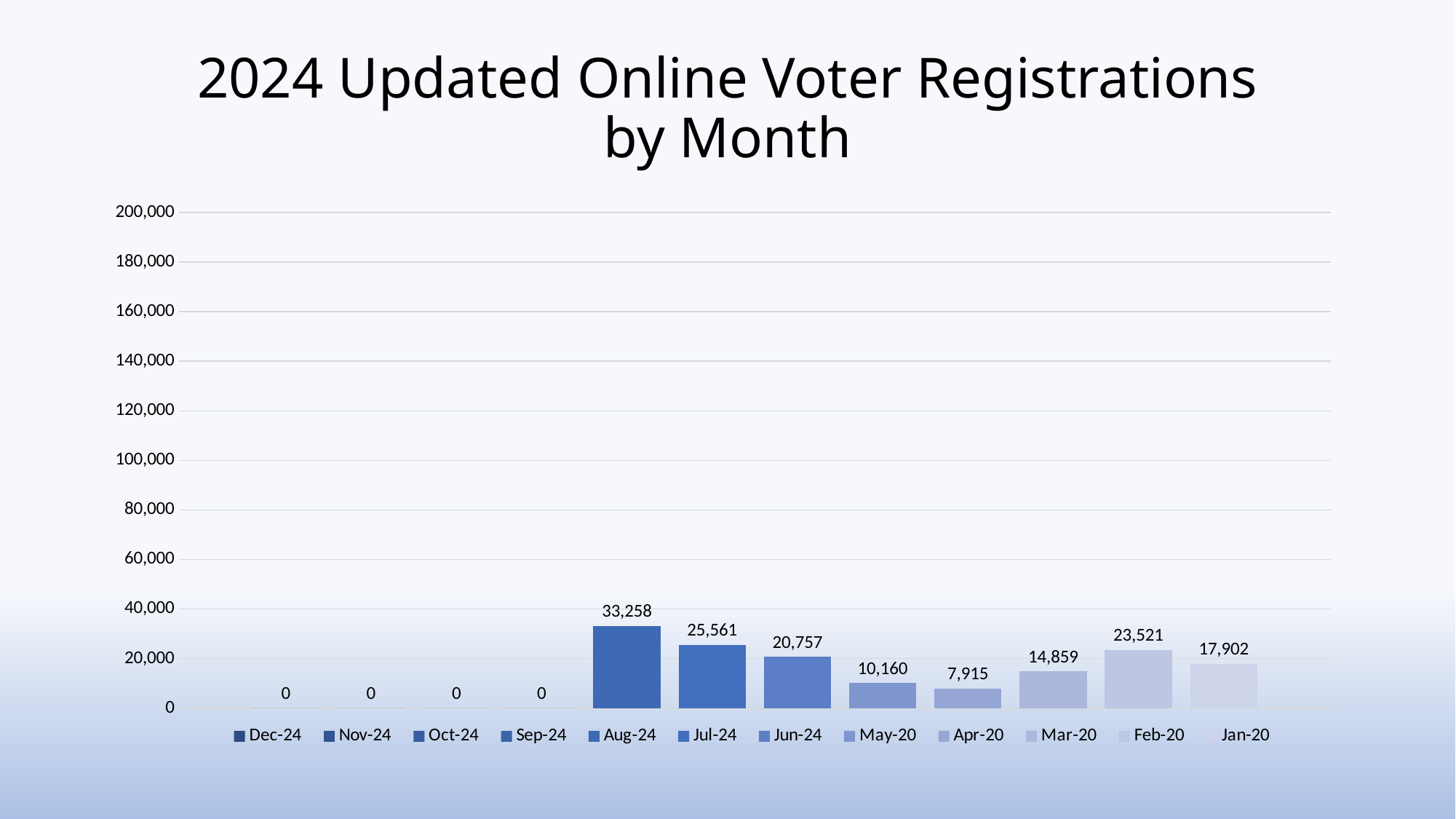
What is the difference between the values for Aug-24 and Jul-24? 7,697 What is the value for Jul-24? 25,561 What is the value for Feb-20? 23,521 Which month has the highest value? Aug-24 What is the title of the chart? 2024 Updated Online Voter Registrations by Month What is the value for Apr-20? 7,915 What kind of chart is shown on the slide? Bar chart How many entries does the legend list? 12 What is the value for Aug-24? 33,258 Is the value for Mar-20 greater or less than 20,000? less Which is larger, the value for Jun-24 or the value for Feb-20? Feb-20 Among the months with a non-zero value, which has the lowest value? Apr-20